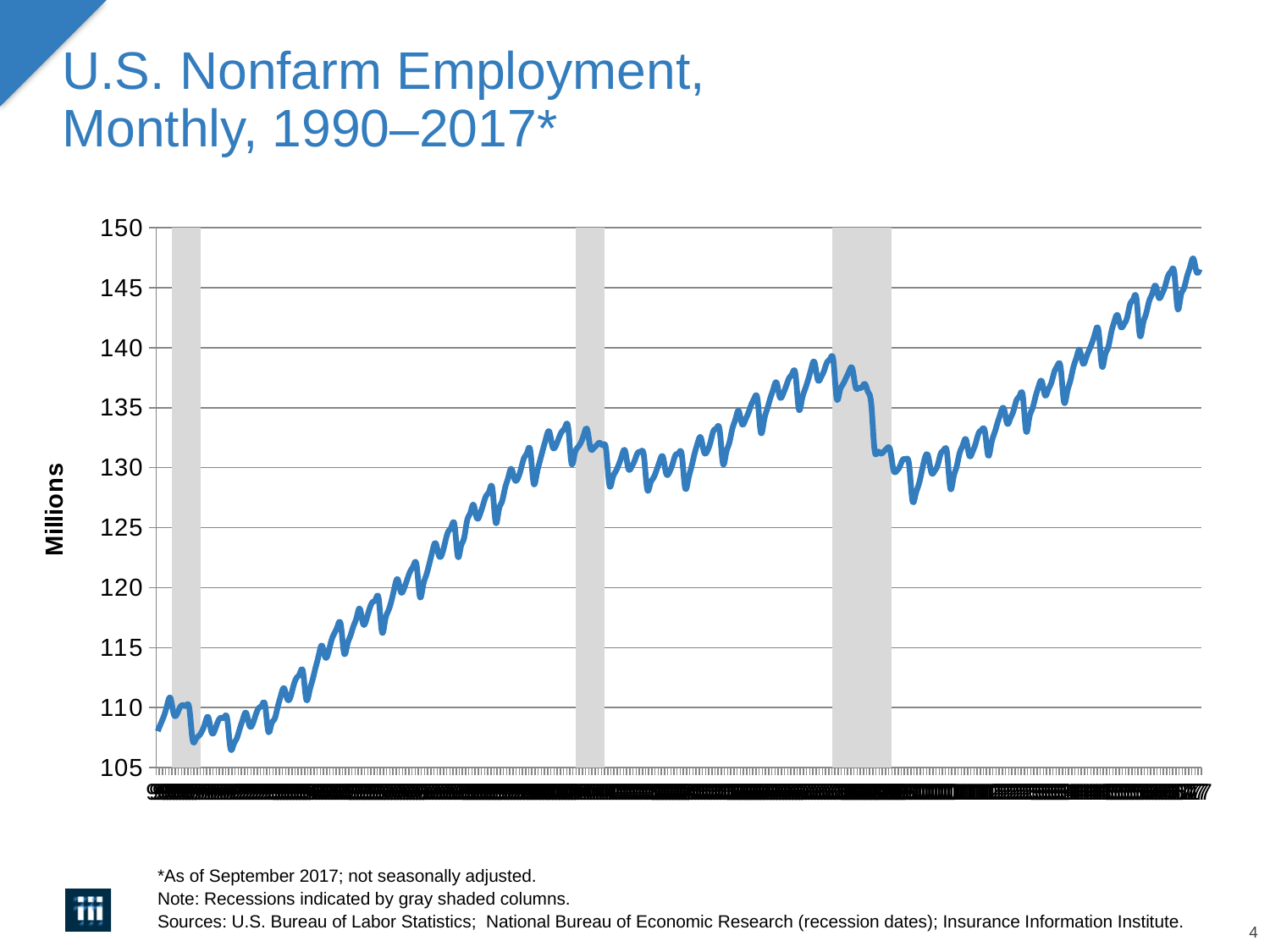
Is the value at the end of the series higher or lower than the value at the start of the series? higher Is the lowest point of the line greater or less than 110? less According to the note, what do the gray shaded columns indicate? Recessions Is the highest point of the line greater or less than 145? greater What is the label on the vertical axis? Millions Is the value at the start of the series (1990) greater or less than 115? less Over the whole period from 1990 to 2017, does U.S. nonfarm employment generally rise or fall? rise What kind of chart is shown on the slide? line chart